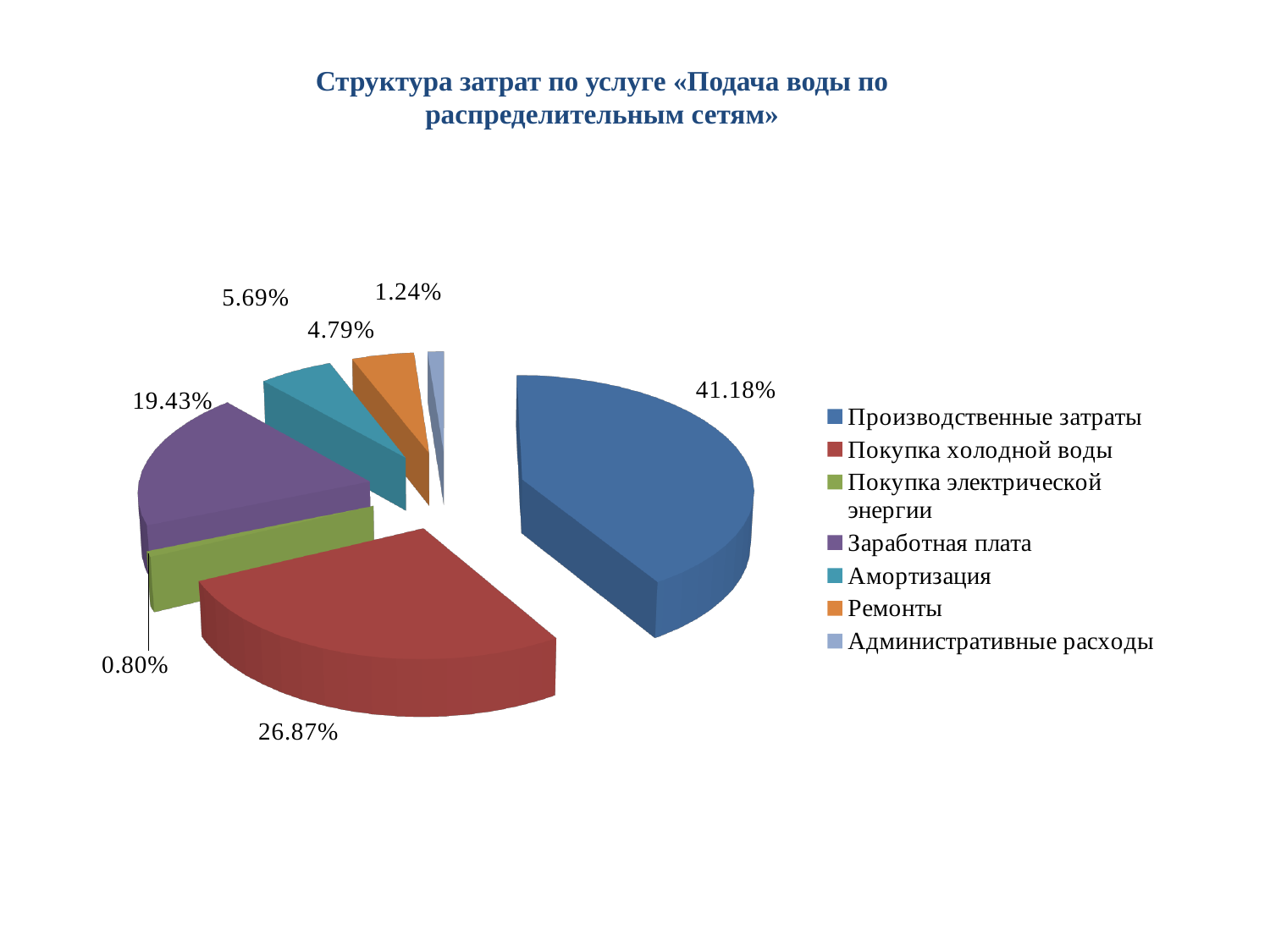
What share of costs is shown for Производственные затраты? 41.18% What share of costs is shown for Покупка холодной воды? 26.87% Which category has the largest share of the pie? Производственные затраты What is the title of the chart? Структура затрат по услуге «Подача воды по распределительным сетям» Which category has the smallest share of the pie? Покупка электрической энергии Which is larger, the share for Амортизация or the share for Ремонты? Амортизация What is the difference between the shares of Производственные затраты and Покупка холодной воды? 14.31% What share of costs is shown for Покупка электрической энергии? 0.80% What share of costs is shown for Заработная плата? 19.43% What share of costs is shown for Амортизация? 5.69% How many categories does the legend list? 7 What type of chart is shown on the slide? Pie chart